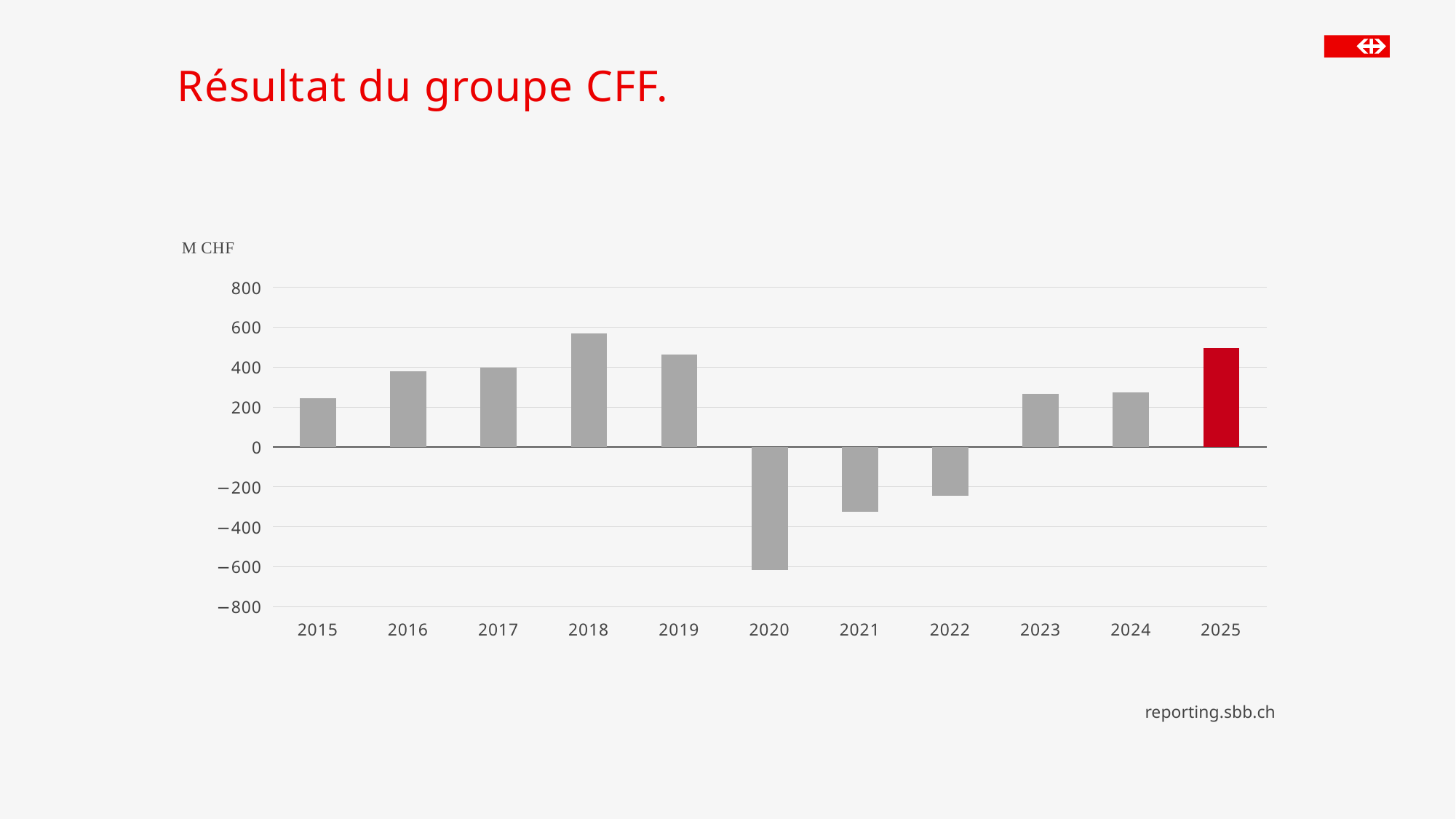
Is the value for 2021 greater or less than -200? less Which year has the larger value, 2018 or 2019? 2018 Is the value for 2015 greater or less than 200? greater Is the value for 2020 greater or less than -400? less Which year has the lowest value in the chart? 2020 What is the title of the slide? Résultat du groupe CFF. Which year's bar is shown in red? 2025 What kind of chart is shown on the slide? bar chart How many years are shown on the x axis of the chart? 11 Which year has the highest value in the chart? 2018